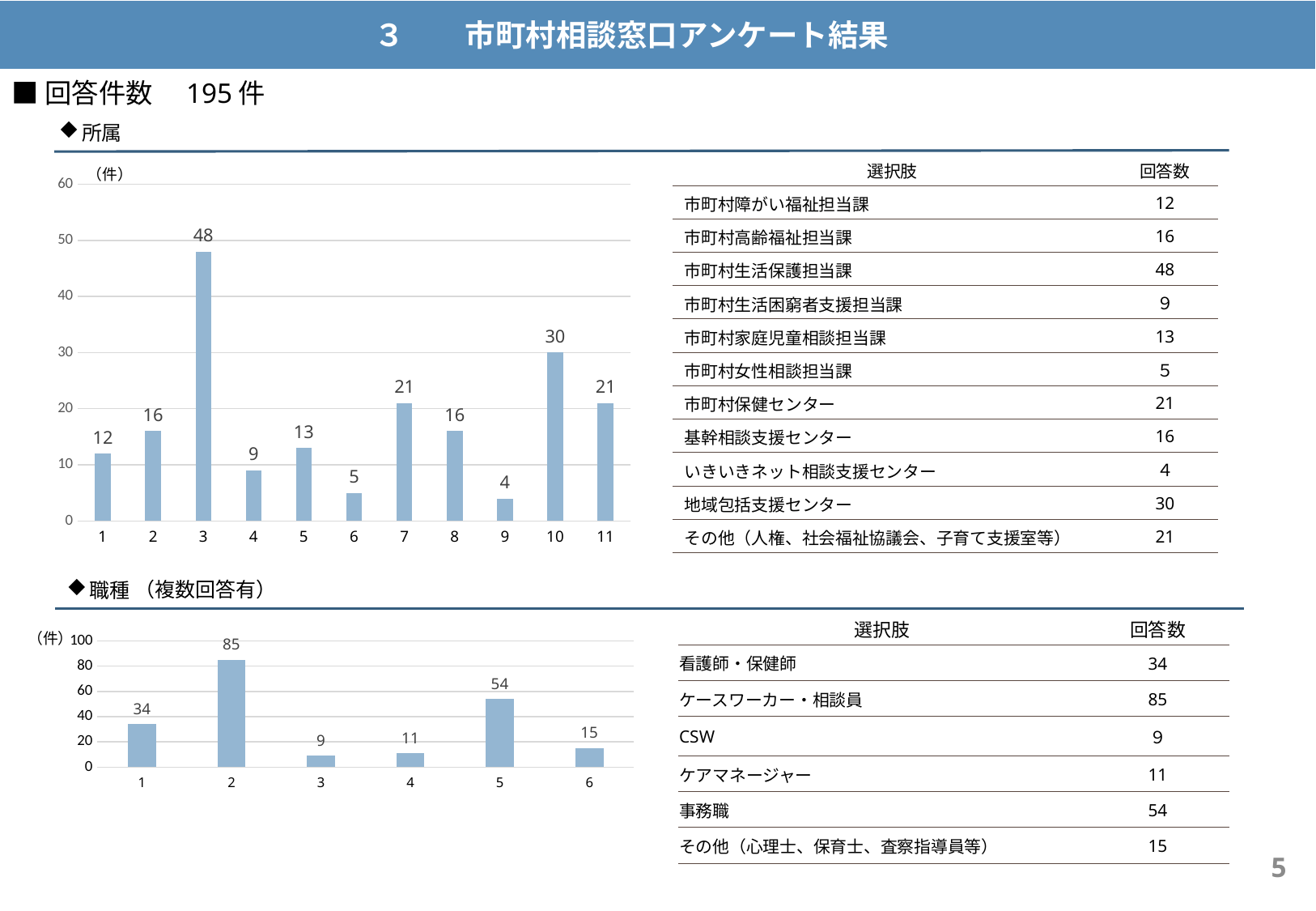
What kind of chart is the 職種 chart at the bottom of the slide? Bar chart In the 所属 chart at the top, which category has the highest value? 3 In the 所属 chart at the top, how many categories are plotted on the x axis? 11 In the 所属 (affiliation) chart at the top, what is the value for category 3? 48 In the 職種 chart at the bottom, what is the difference between the values for category 2 and category 5? 31 In the 所属 chart at the top, which category has the lowest value? 9 In the 所属 chart at the top, which is larger, the value for category 7 or the value for category 8? Category 7 In the 所属 chart at the top, what is the difference between the values for category 3 and category 10? 18 In the 職種 chart at the bottom, which category has the lowest value? 3 In the 職種 chart at the bottom, how many categories are plotted on the x axis? 6 In the 所属 chart at the top, what is the value for category 10? 30 In the 職種 (occupation) chart at the bottom, what is the value for category 2? 85